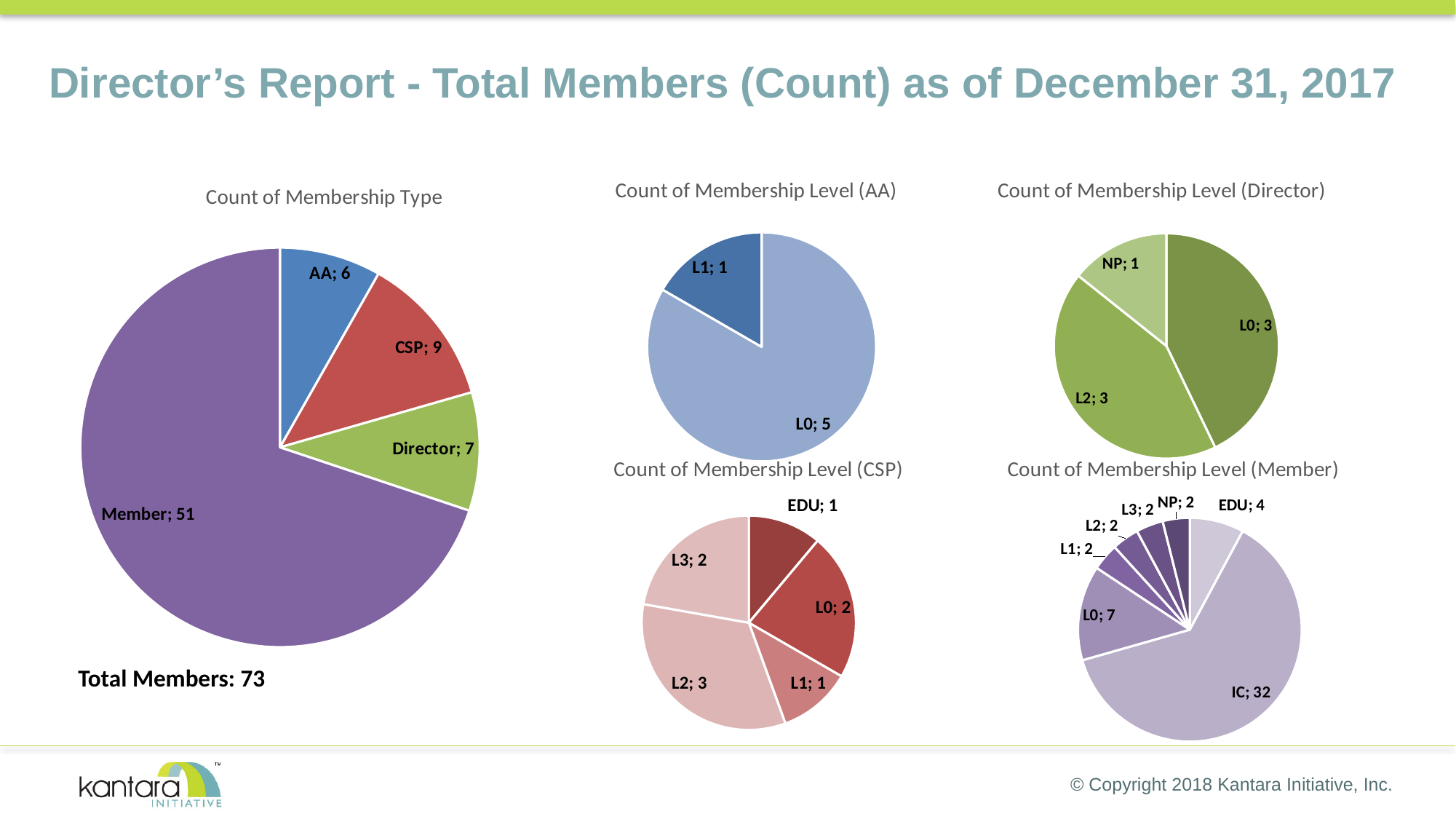
In the 'Count of Membership Level (Member)' chart, what is the difference between IC and L0? 25 In the 'Count of Membership Level (CSP)' chart, which is larger, L0 or L3? They are equal (2) In the 'Count of Membership Type' chart, what is the value for Member? 51 In the 'Count of Membership Level (AA)' chart, what is the value for L0? 5 In the 'Count of Membership Type' chart, which category has the lowest count? AA In the 'Count of Membership Level (Director)' chart, which category has the smallest slice? NP What kind of chart is 'Count of Membership Level (AA)'? Pie chart How many categories are shown in the 'Count of Membership Level (Member)' chart? 7 In the 'Count of Membership Level (CSP)' chart, which category has the largest slice? L2 In the 'Count of Membership Type' chart, what is the difference between CSP and Director? 2 What total number of members is stated on the slide? 73 How many categories are shown in the 'Count of Membership Type' chart? 4